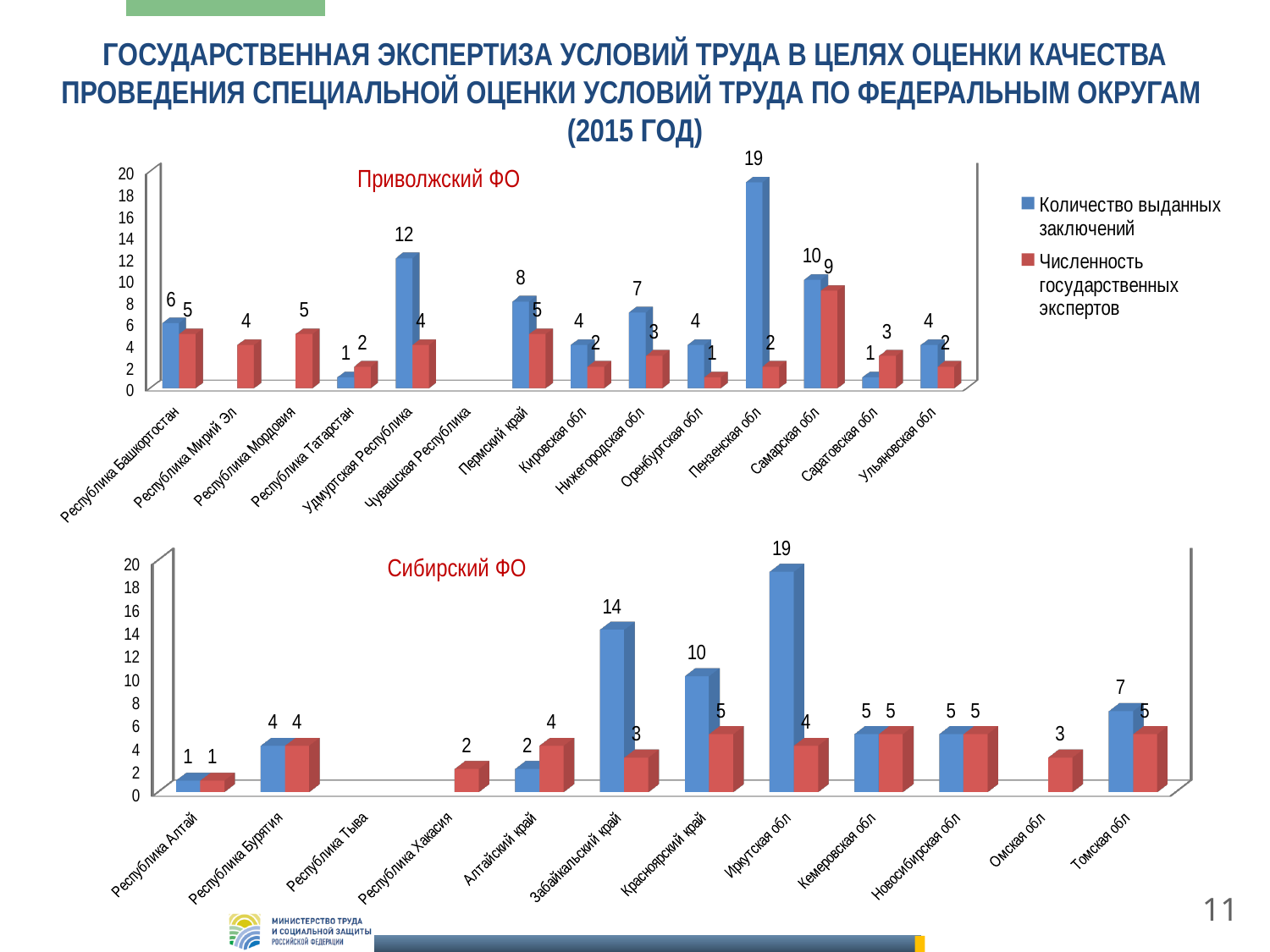
In the Сибирский ФО chart, how many regions are listed on the x axis? 12 In the Сибирский ФО chart, what is the difference between Количество выданных заключений and Численность государственных экспертов for Красноярский край? 5 In the Приволжский ФО chart, what is the value of Количество выданных заключений for Пензенская обл? 19 In the Приволжский ФО chart, which region has the highest Количество выданных заключений? Пензенская обл What type of chart is the Сибирский ФО chart? Bar chart In the Приволжский ФО chart, what is the difference between Количество выданных заключений and Численность государственных экспертов for Удмуртская Республика? 8 In the Сибирский ФО chart, which region has the highest Количество выданных заключений? Иркутская обл In the Сибирский ФО chart, which is larger for Алтайский край: Количество выданных заключений or Численность государственных экспертов? Численность государственных экспертов In the Приволжский ФО chart, how many regions are listed on the x axis? 14 How many series does the legend list? 2 In the Приволжский ФО chart, what is the value of Численность государственных экспертов for Самарская обл? 9 In the Сибирский ФО chart, what is the value of Количество выданных заключений for Забайкальский край? 14